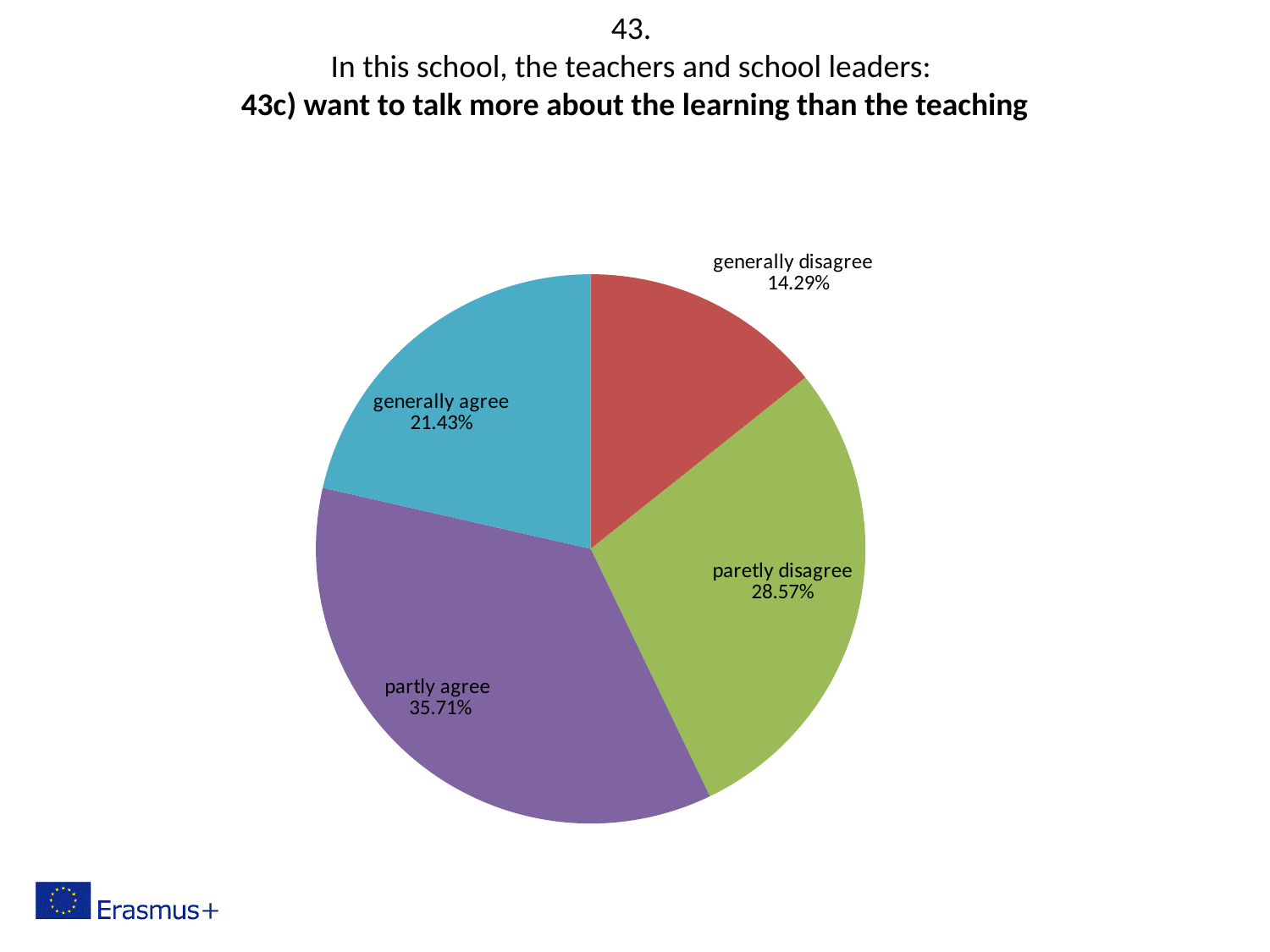
What colour is the 'partly agree' slice? purple What share of the pie is labelled 'generally disagree'? 14.29% What is the difference in percentage points between the 'partly agree' slice and the 'generally disagree' slice? 21.42 What share of the pie is labelled 'paretly disagree'? 28.57% How many slices does the pie chart have? 4 Which slice of the pie is the largest? partly agree Which slice of the pie is the smallest? generally disagree Which is larger, the 'generally agree' slice or the 'paretly disagree' slice? paretly disagree What share of the pie is labelled 'generally agree'? 21.43% What share of the pie is labelled 'partly agree'? 35.71% What is the combined share of the 'partly agree' and 'generally agree' slices? 57.14% What kind of chart is shown on the slide? pie chart